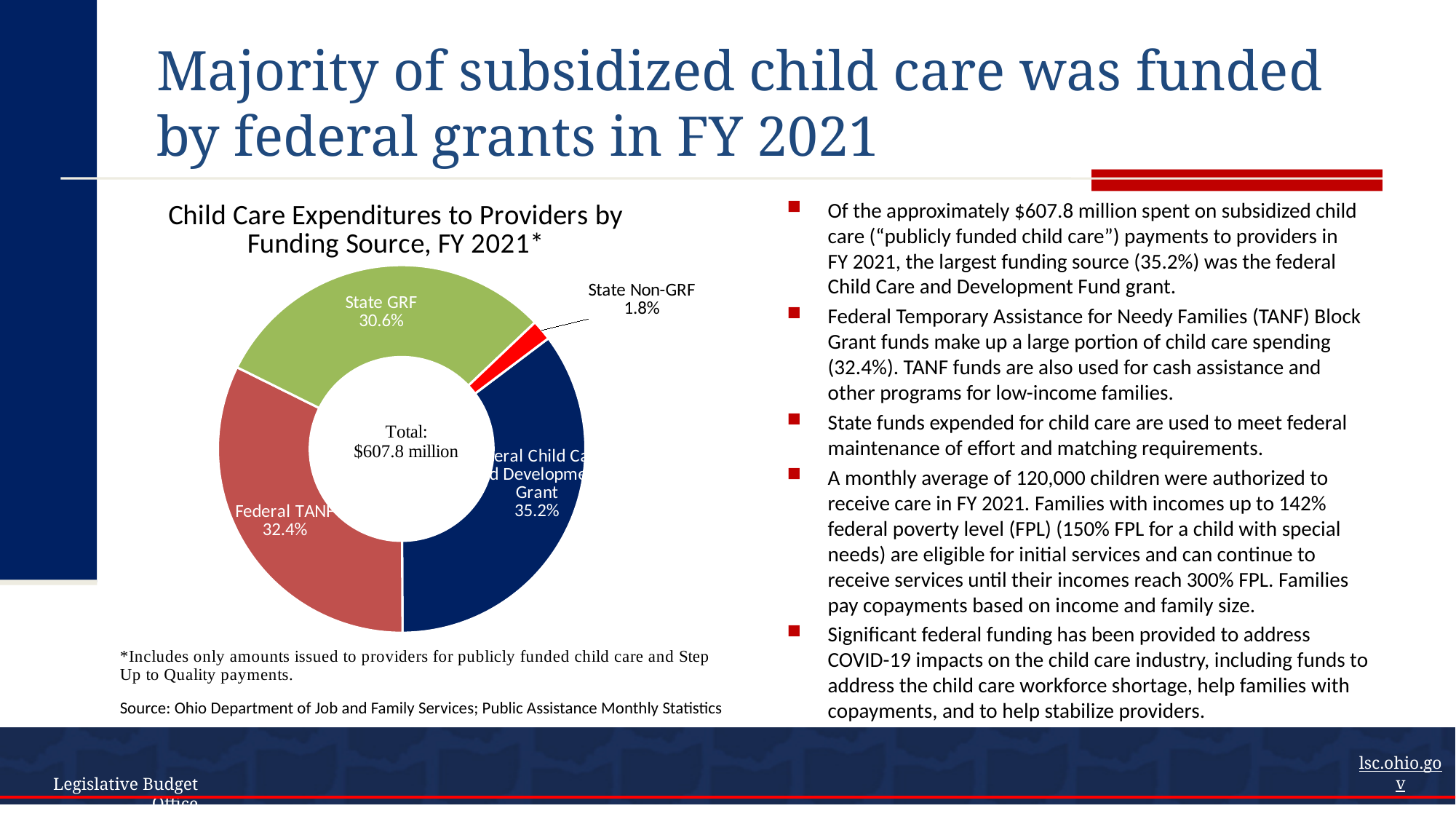
Which funding source has the largest share of child care expenditures? Federal Child Care and Development Grant What is the difference in percentage points between the Federal TANF share and the State GRF share? 1.8 percentage points What is the title of the chart? Child Care Expenditures to Providers by Funding Source, FY 2021* What share of child care expenditures came from the Federal Child Care and Development Grant? 35.2% What type of chart is shown on the slide? Pie chart (donut) What total amount is shown in the center of the chart? $607.8 million What share of child care expenditures came from State Non-GRF? 1.8% Which is larger, the Federal TANF share or the State GRF share? Federal TANF What share of child care expenditures came from State GRF? 30.6% Which funding source has the smallest share of child care expenditures? State Non-GRF How many funding sources are shown in the chart? 4 What share of child care expenditures came from Federal TANF? 32.4%